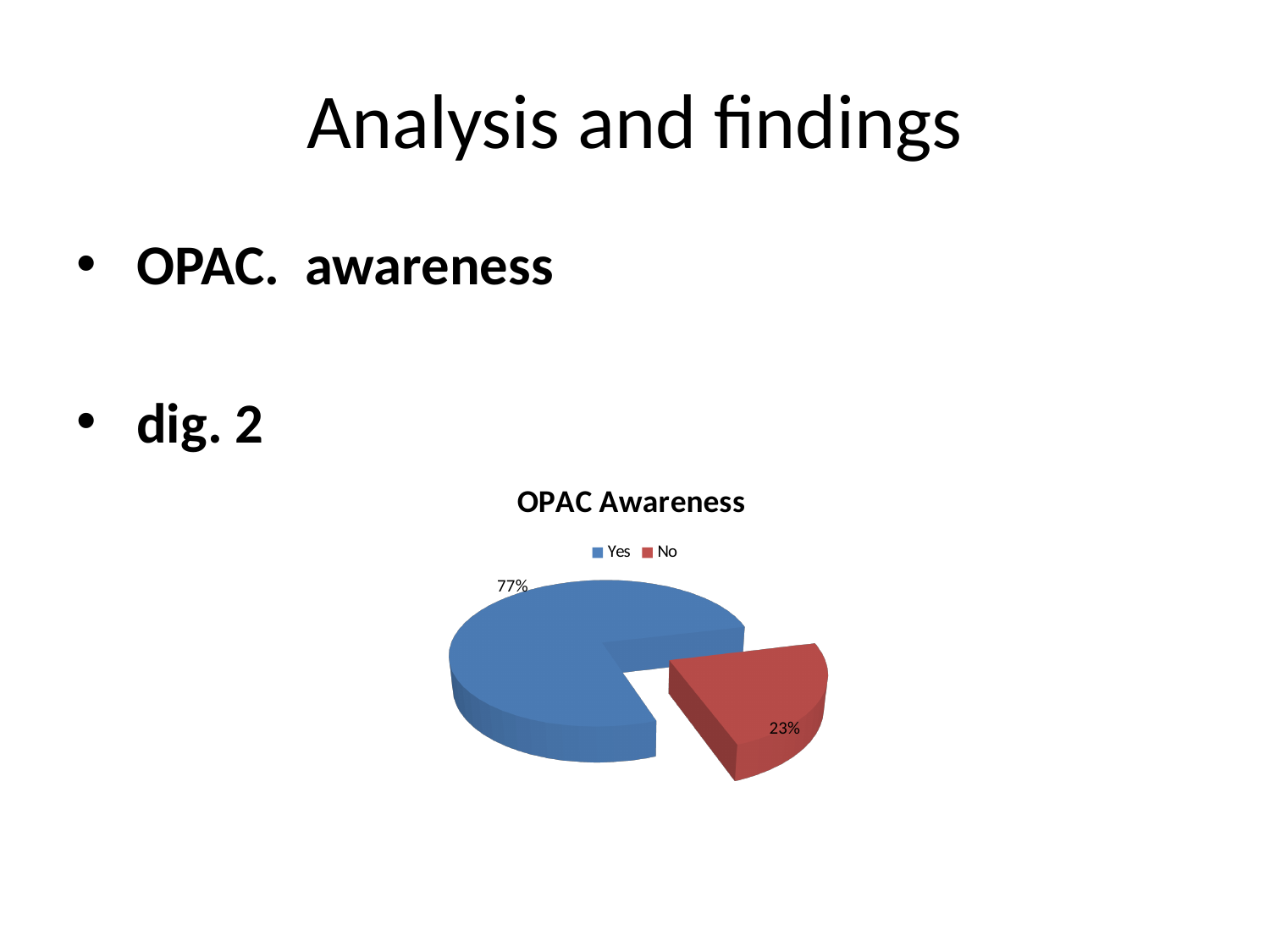
What colour is the Yes slice? blue What percentage of the pie is labelled Yes? 77% How many slices does the pie chart have? 2 Which slice is the smallest in the pie chart? No What type of chart is shown on the slide? pie chart Which slice is larger, Yes or No? Yes What share of the pie does the No slice represent? 23% What is the difference in percentage points between the Yes and No slices? 54 What is the title of the chart? OPAC Awareness Which slice is the largest in the pie chart? Yes What percentage of the pie is labelled No? 23% How many entries does the legend list? 2